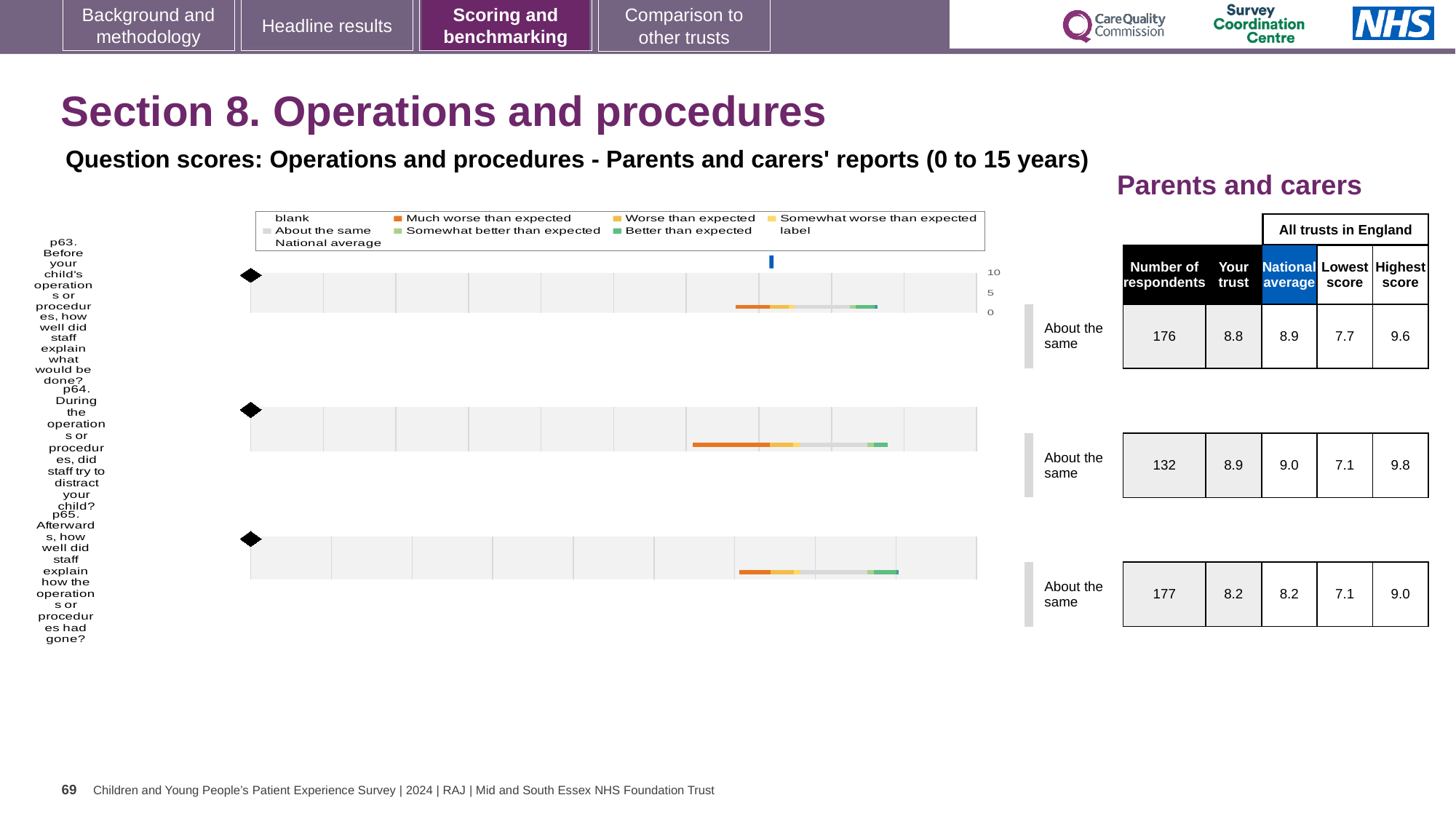
What benchmark category is shown next to the chart for p63 (Before your child's operations or procedures, how well did staff explain what would be done?)? About the same What is the difference between the highest score and the lowest score for p64 (During the operations or procedures, did staff try to distract your child?)? 2.7 Which question has the lowest 'Your trust' score: p63, p64 or p65? p65 What kind of chart is used to show the question scores on this slide? bar chart How many question charts (p63, p64, p65) are shown on the slide? 3 How many respondents answered p65 (Afterwards, how well did staff explain how the operations or procedures had gone?)? 177 Is the 'Your trust' score for p63 higher or lower than the 'Your trust' score for p64? lower What is the national average for p64 (During the operations or procedures, did staff try to distract your child?)? 9.0 What is the 'Your trust' score for p63 (Before your child's operations or procedures, how well did staff explain what would be done?)? 8.8 What is the highest score across all trusts in England for p65 (Afterwards, how well did staff explain how the operations or procedures had gone?)? 9.0 What is the highest value shown on the axis of the question score charts? 10 In the chart legend, which colour represents 'Much worse than expected'? orange